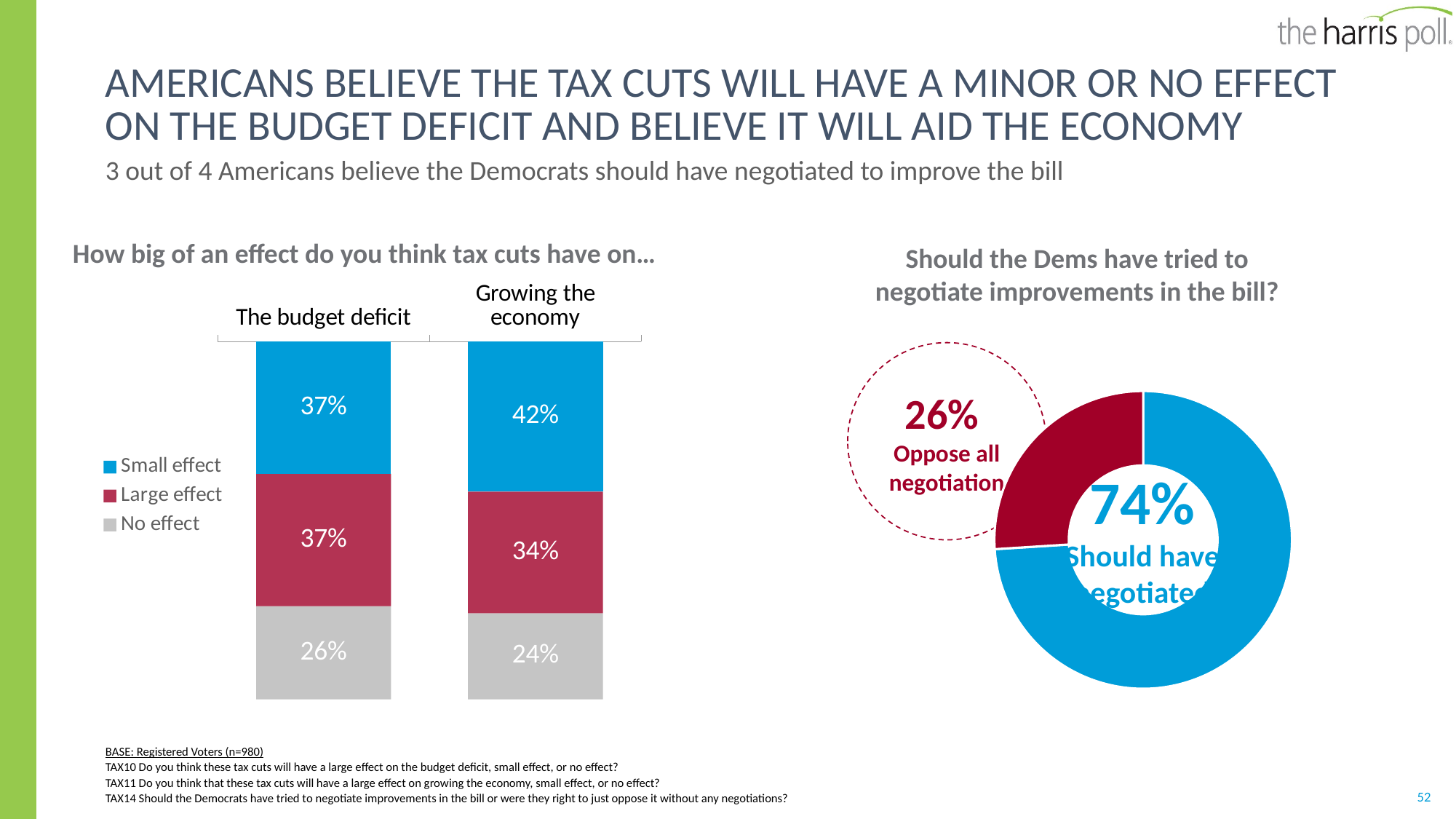
In the stacked bar chart 'How big of an effect do you think tax cuts have on...', what percentage say the tax cuts will have a small effect on growing the economy? 42% In the stacked bar chart 'How big of an effect do you think tax cuts have on...', what is the difference between the 'Small effect' values for growing the economy and the budget deficit? 5 percentage points In the donut chart 'Should the Dems have tried to negotiate improvements in the bill?', what share of the chart is 'Oppose all negotiation'? 26% In the stacked bar chart 'How big of an effect do you think tax cuts have on...', how many series does the legend list? 3 In the stacked bar chart 'How big of an effect do you think tax cuts have on...', how many categories are shown on the x axis? 2 In the donut chart 'Should the Dems have tried to negotiate improvements in the bill?', which slice is the largest? Should have negotiated In the stacked bar chart 'How big of an effect do you think tax cuts have on...', what percentage say the tax cuts will have no effect on the budget deficit? 26% In the donut chart 'Should the Dems have tried to negotiate improvements in the bill?', what percentage say the Democrats should have negotiated? 74% In the stacked bar chart 'How big of an effect do you think tax cuts have on...', what is the total of the stacked bar for the budget deficit? 100% What kind of chart is used for 'How big of an effect do you think tax cuts have on...'? Stacked bar chart In the stacked bar chart 'How big of an effect do you think tax cuts have on...', which category has the larger 'Large effect' value, the budget deficit or growing the economy? The budget deficit In the stacked bar chart 'How big of an effect do you think tax cuts have on...', what percentage say the tax cuts will have a large effect on growing the economy? 34%